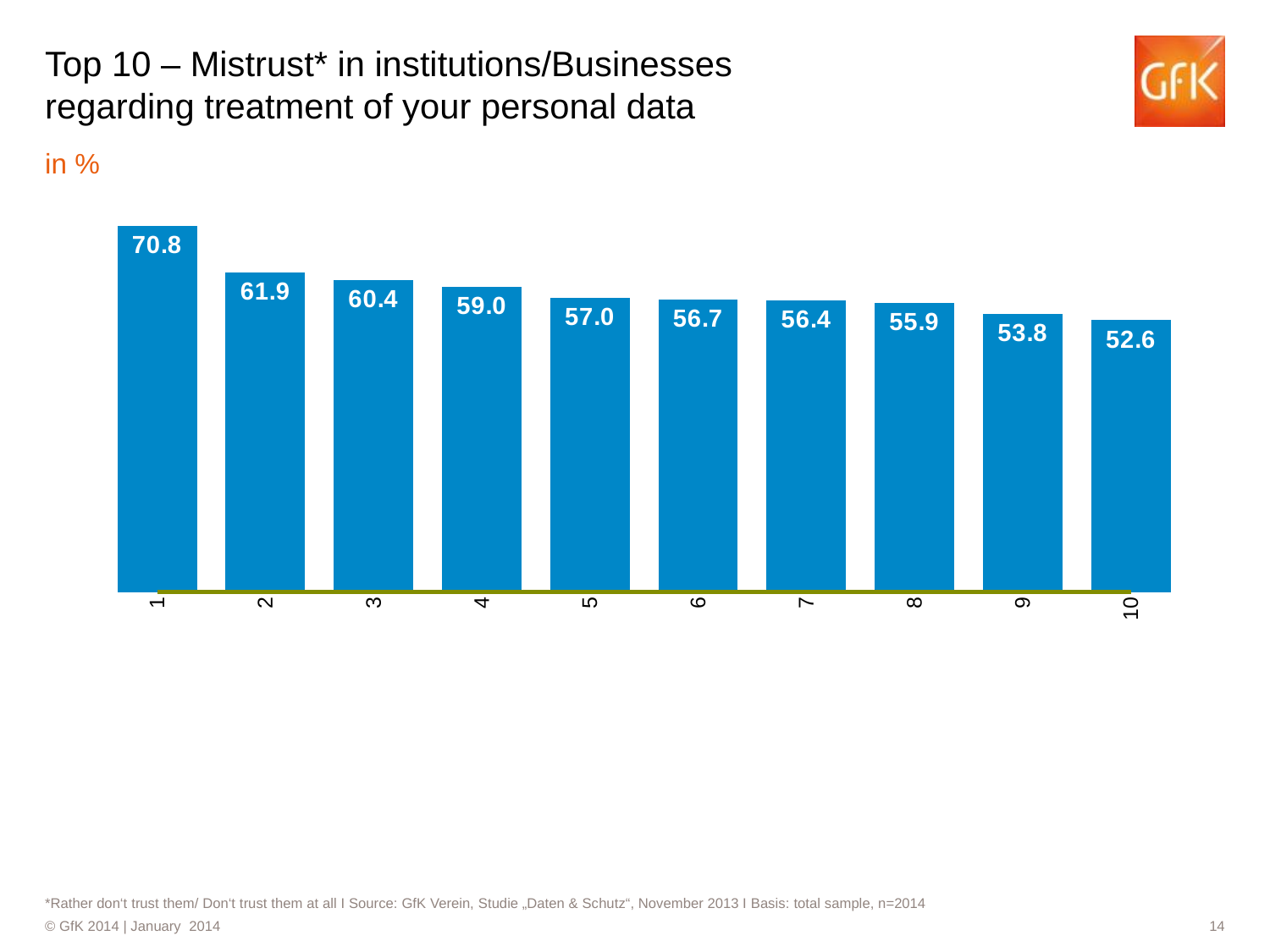
What is the difference between the values for category 1 and category 2? 8.9 What unit are the values in, according to the subtitle? % Which category has the lowest value? 10 Which category has the highest value? 1 How many categories are shown in the chart? 10 What is the value for category 1? 70.8 What kind of chart is shown on the slide? bar chart Which is larger, the value for category 3 or the value for category 4? category 3 What is the value for category 5? 57.0 What is the value for category 10? 52.6 Do the values rise or fall from category 1 to category 10? fall What is the difference between the values for category 9 and category 10? 1.2